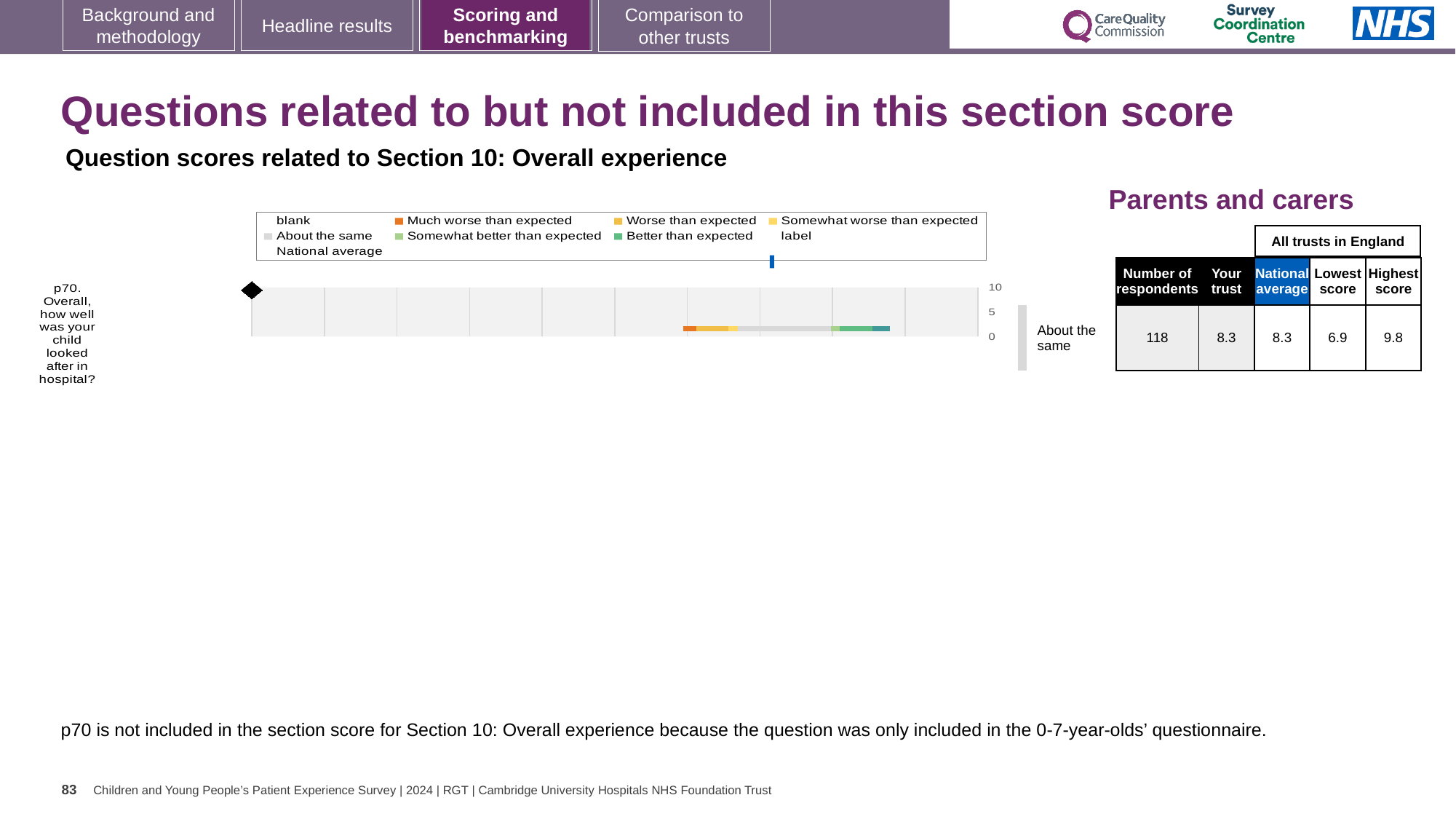
What benchmark category label is shown for the trust's p70 result? About the same Is the trust's score for p70 greater or less than 5? greater What is the 'Your trust' score for p70? 8.3 Which survey question is plotted in the chart? p70. Overall, how well was your child looked after in hospital? What is the highest score among all trusts in England for p70? 9.8 What is the difference between the highest and lowest trust scores for p70? 2.9 Which respondent group does the chart and table refer to? Parents and carers What is the lowest score among all trusts in England for p70? 6.9 How many survey questions are plotted in the chart? 1 What type of chart is used to show the p70 result? bar chart What is the national average score for p70? 8.3 How many respondents answered p70? 118